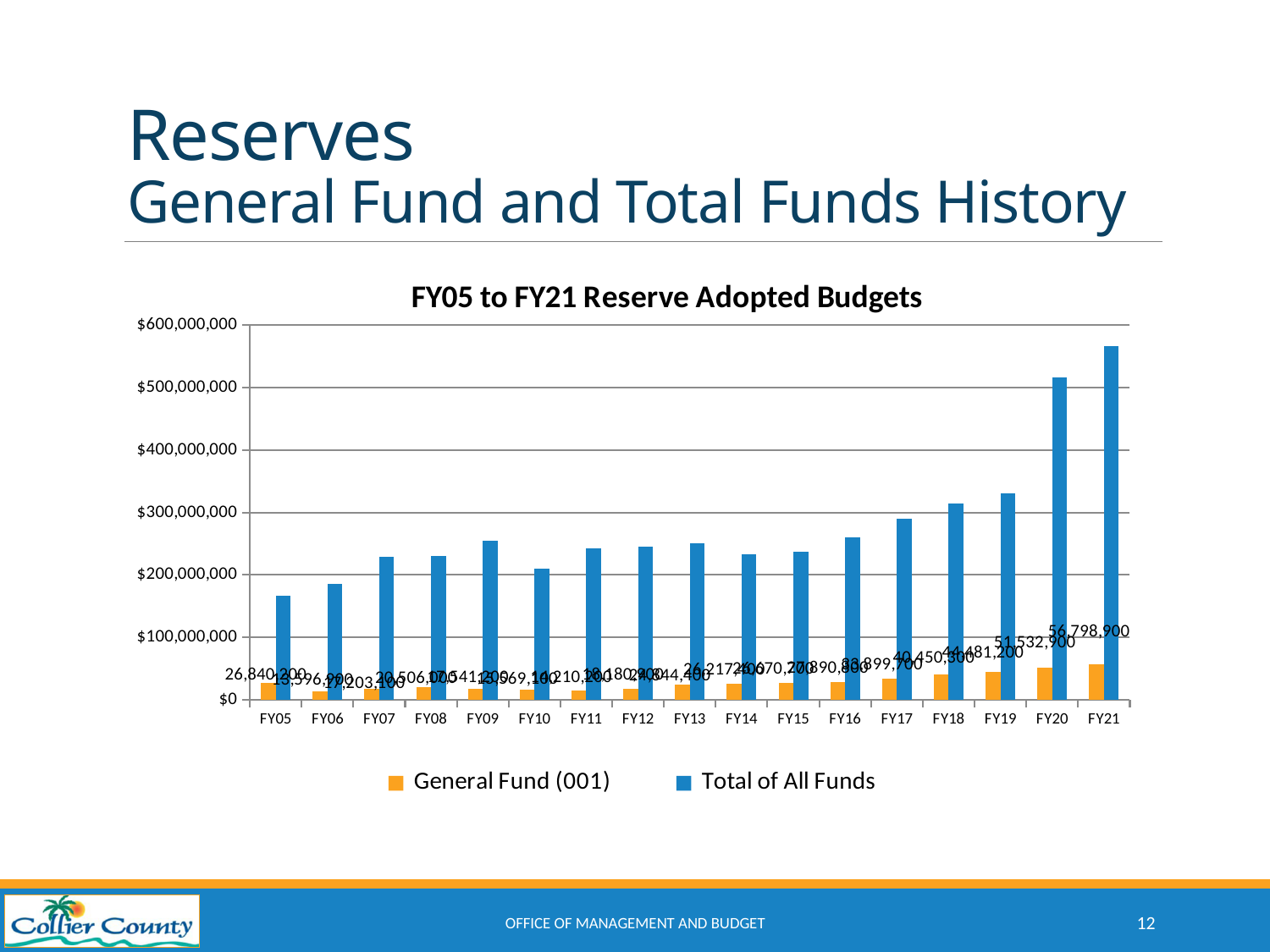
What type of chart is shown on the slide? Bar chart Is the Total of All Funds value for FY05 greater or less than $200,000,000? less What is the General Fund (001) value for FY21? 56,798,900 How many series does the legend list? 2 What is the title of the chart? FY05 to FY21 Reserve Adopted Budgets What is the difference between the General Fund (001) values for FY21 and FY20? 5,266,000 Which fiscal year has the lowest Total of All Funds value? FY05 What is the General Fund (001) value for FY05? 26,840,200 Is the Total of All Funds value for FY21 greater or less than $500,000,000? greater How many fiscal years are shown on the x axis? 17 What is the General Fund (001) value for FY20? 51,532,900 Which fiscal year has the highest Total of All Funds value? FY21